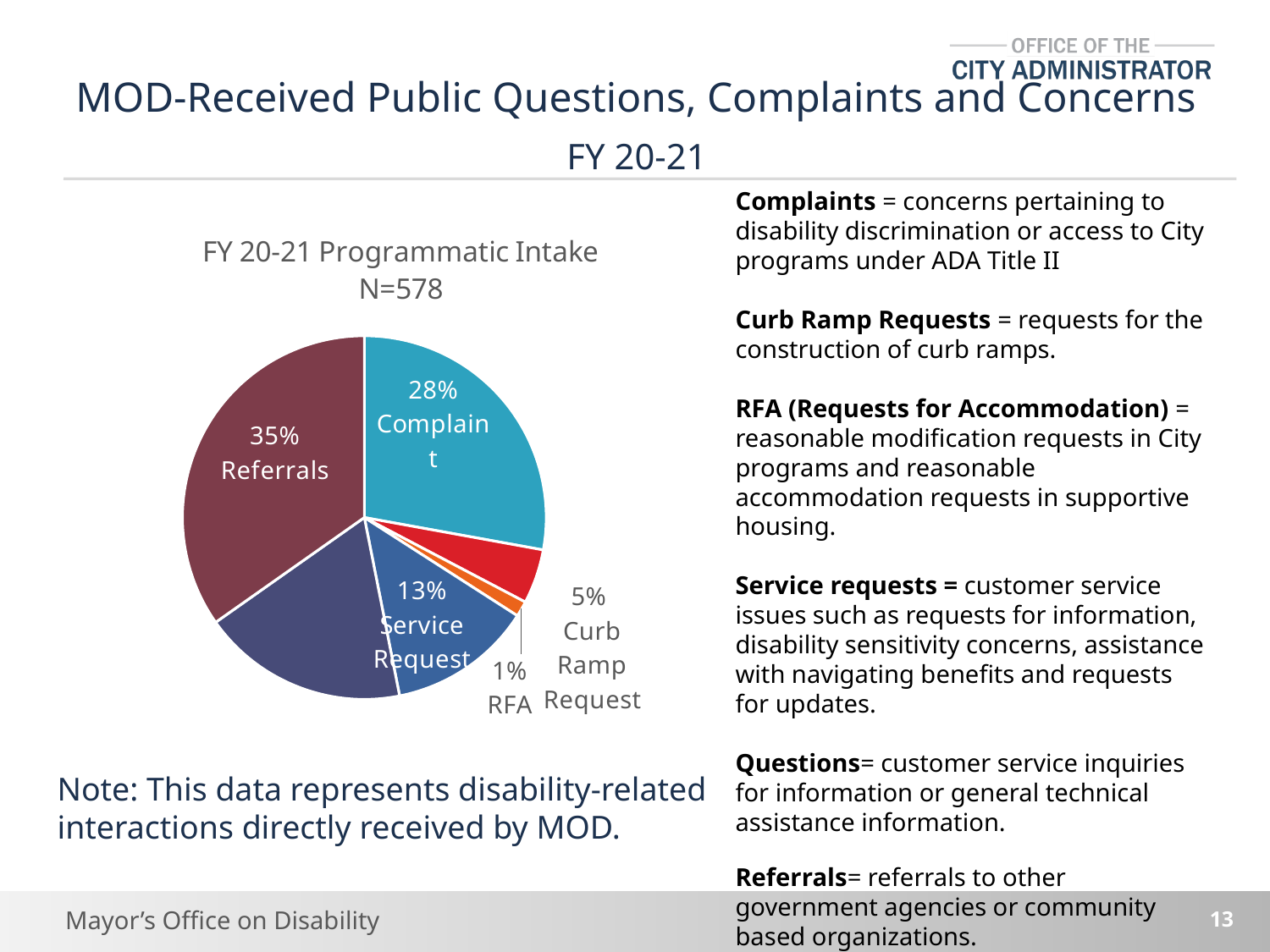
What percentage of the pie is Referrals? 35% What percentage of the pie is Curb Ramp Request? 5% How many percentage points larger is Referrals than Complaint? 7 What percentage of the pie is Service Request? 13% What percentage of the pie is Complaint? 28% What is the title of the chart? FY 20-21 Programmatic Intake N=578 Which is larger, the share for Complaint or the share for Service Request? Complaint Which labeled category has the smallest share of the pie? RFA What kind of chart is shown on the slide? pie chart What percentage of the pie is RFA? 1% Which labeled category has the largest share of the pie? Referrals What is the total N shown in the chart title? 578